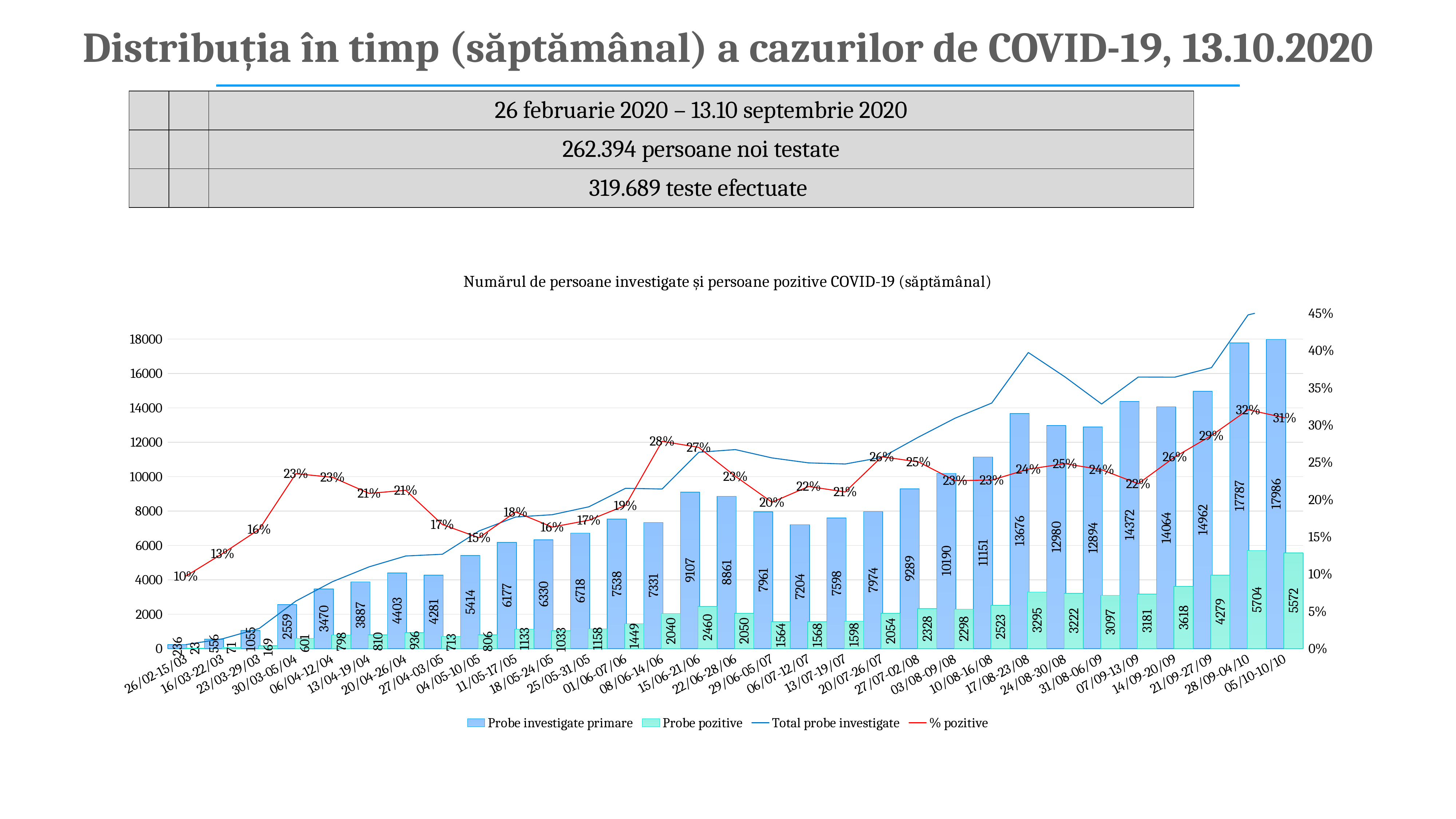
How many series does the legend list? 4 Which week has the highest % pozitive value? 28/09-04/10 What is the value of Probe pozitive for the week 28/09-04/10? 5704 Which is larger: Probe investigate primare for 17/08-23/08 or for 24/08-30/08? 17/08-23/08 What is the difference between Probe investigate primare for 05/10-10/10 and for 28/09-04/10? 199 What is the value of Probe investigate primare for the week 05/10-10/10? 17986 Is the value of Probe investigate primare for 15/06-21/06 greater or less than 8000? greater Which week has the lowest value of Probe investigate primare? 26/02-15/03 What is the % pozitive value for the week 08/06-14/06? 28% How many weekly categories are shown on the x axis? 31 What is the title of the chart? Numărul de persoane investigate și persoane pozitive COVID-19 (săptămânal) Which week has the highest value of Probe pozitive? 28/09-04/10